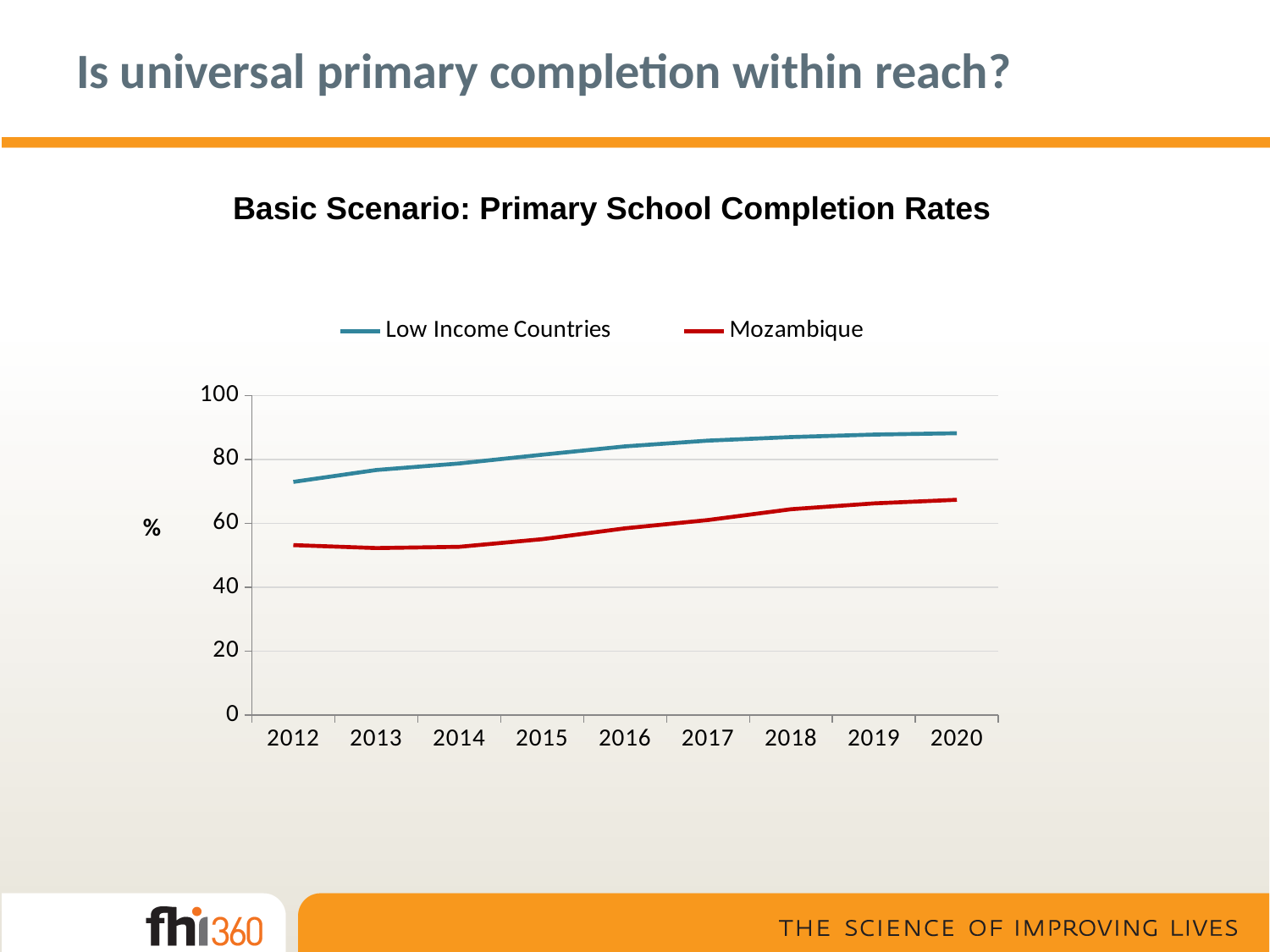
Is the value for Low Income Countries in 2012 greater or less than 80? less Does the Low Income Countries line rise or fall from 2012 to 2020? Rises What is the title of the chart? Basic Scenario: Primary School Completion Rates How many years are shown on the x axis? 9 Is the value for Mozambique in 2012 greater or less than 60? less Is the value for Mozambique in 2020 greater or less than 60? greater What type of chart is shown on the slide? Line chart How many series does the legend list? 2 In which year is the Low Income Countries value lowest? 2012 In which year is the Mozambique value highest? 2020 Which series has the higher value in 2020, Low Income Countries or Mozambique? Low Income Countries